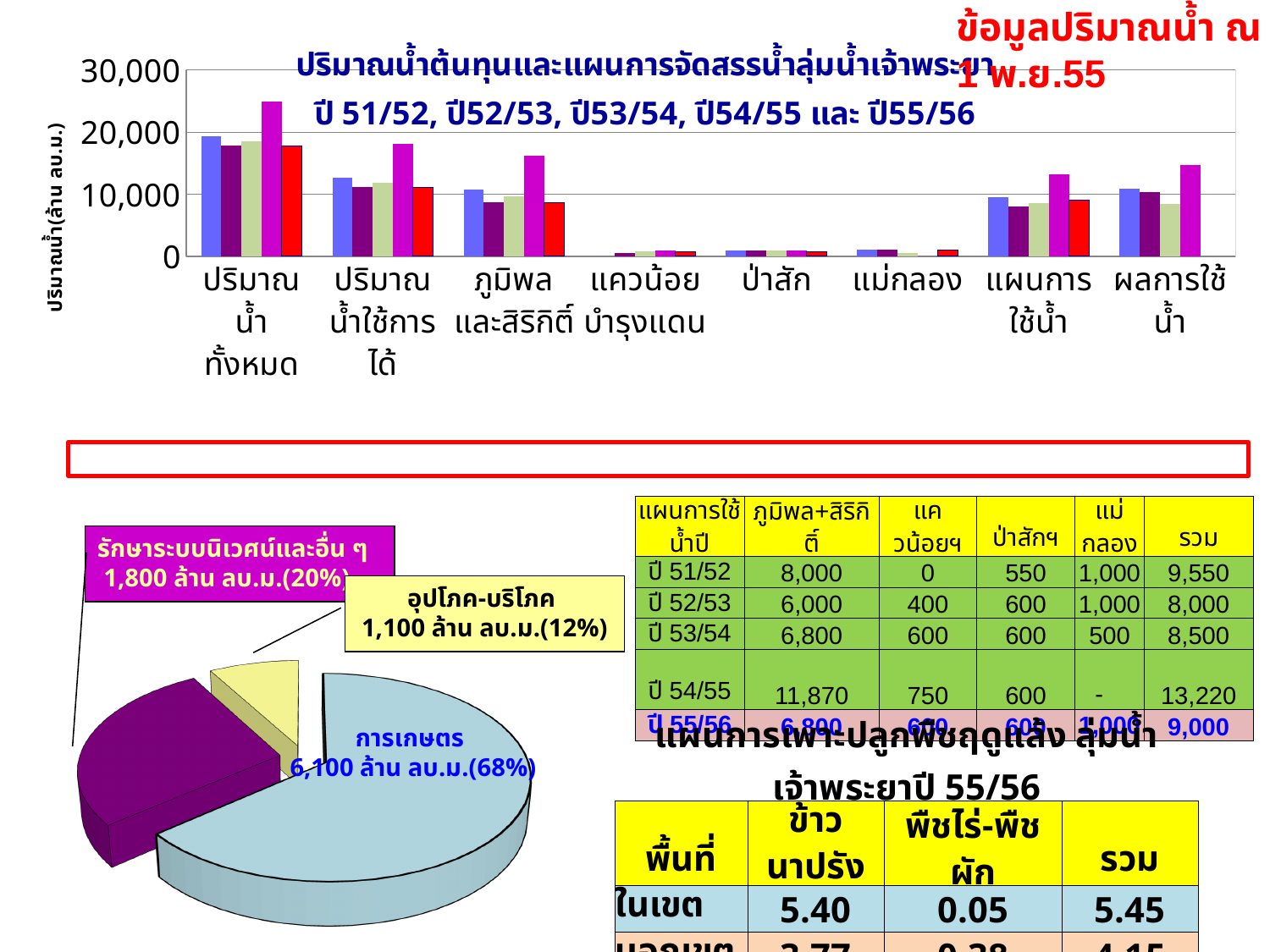
In the bottom-left pie chart, which slice is the smallest? อุปโภค-บริโภค What type of chart is the chart at the bottom left of the slide? pie chart In the top bar chart, is the tallest bar for ปริมาณน้ำทั้งหมด greater or less than 20,000? greater In the top bar chart, is the tallest bar for แม่กลอง greater or less than 10,000? less In the top bar chart, is the tallest bar for ภูมิพลและสิริกิติ์ greater or less than 10,000? greater In the bottom-left pie chart, how many slices are there? 3 In the bottom-left pie chart, what value is shown for การเกษตร? 6,100 ล้าน ลบ.ม. In the bottom-left pie chart, what is the difference between the values for การเกษตร and รักษาระบบนิเวศน์และอื่น ๆ? 4,300 ล้าน ลบ.ม. In the top bar chart, how many categories are shown on the x axis? 8 In the bottom-left pie chart, what share of the pie is อุปโภค-บริโภค? 12% What type of chart is the chart at the top of the slide? bar chart In the top bar chart, which category contains the tallest bar? ปริมาณน้ำทั้งหมด